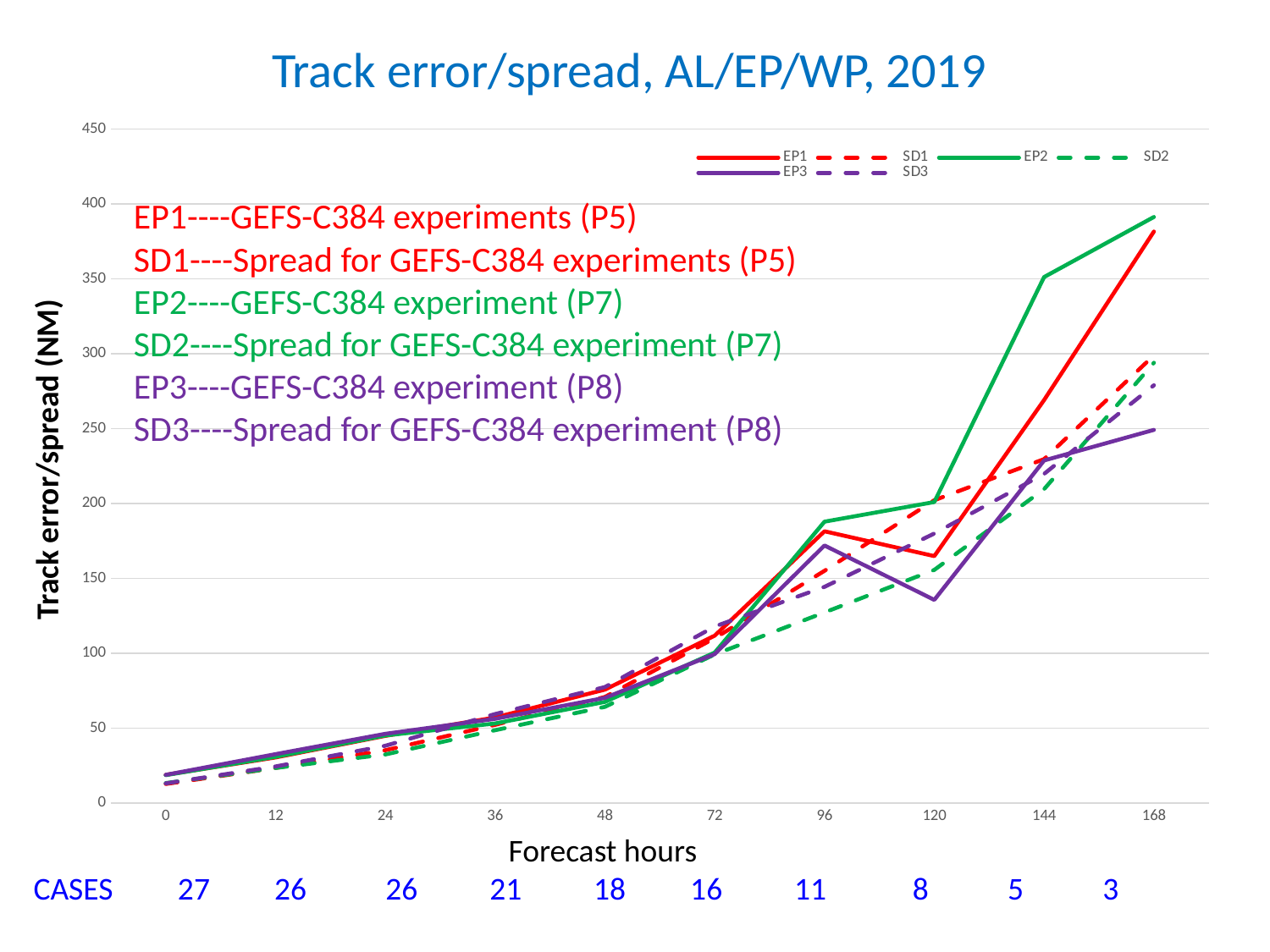
Is the value for EP3 at 120 forecast hours greater or less than 150? less At 120 forecast hours, which is larger, EP2 or EP3? EP2 Is the value for EP2 at 168 forecast hours greater or less than 350? greater How many series does the chart legend list? 6 How many forecast-hour points are shown along the x axis? 10 What is the label of the vertical axis? Track error/spread (NM) Is the value for EP2 at 96 forecast hours greater or less than 150? greater Which series has the lowest value at 168 forecast hours? EP3 What kind of chart is shown on the slide? line chart Which series has the highest value at 144 forecast hours? EP2 What is the title of the chart? Track error/spread, AL/EP/WP, 2019